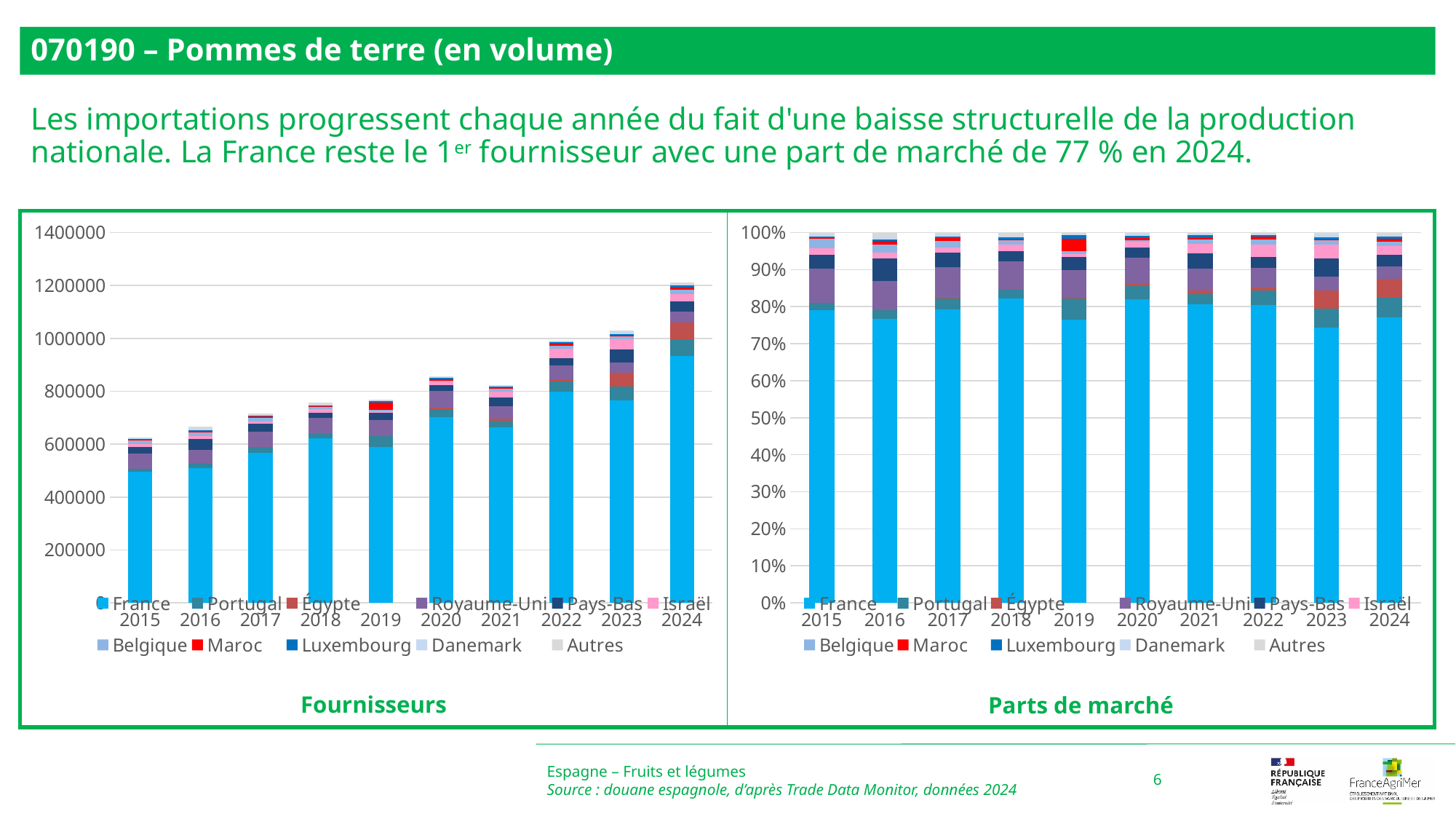
Overall, do the total bars in the 'Fournisseurs' chart rise or fall from 2015 to 2024? rise In the 'Parts de marché' chart, is the share for France in 2024 greater or less than 70%? greater In the 'Fournisseurs' chart, which year has the highest total bar? 2024 In the 'Fournisseurs' chart, which year has the lowest total bar? 2015 What kind of chart is the 'Fournisseurs' chart on the left? Stacked bar chart Which series is shown in red in the legend of the 'Parts de marché' chart? Maroc In the 'Fournisseurs' chart, is the value for France in 2024 greater or less than 800000? greater In the 'Fournisseurs' chart, is the total for 2024 greater or less than 1000000? greater In the 'Fournisseurs' chart, is the total bar for 2022 larger or smaller than the total bar for 2021? larger How many series does the legend of the 'Fournisseurs' chart list? 11 How many years are shown on the x axis of the 'Parts de marché' chart? 10